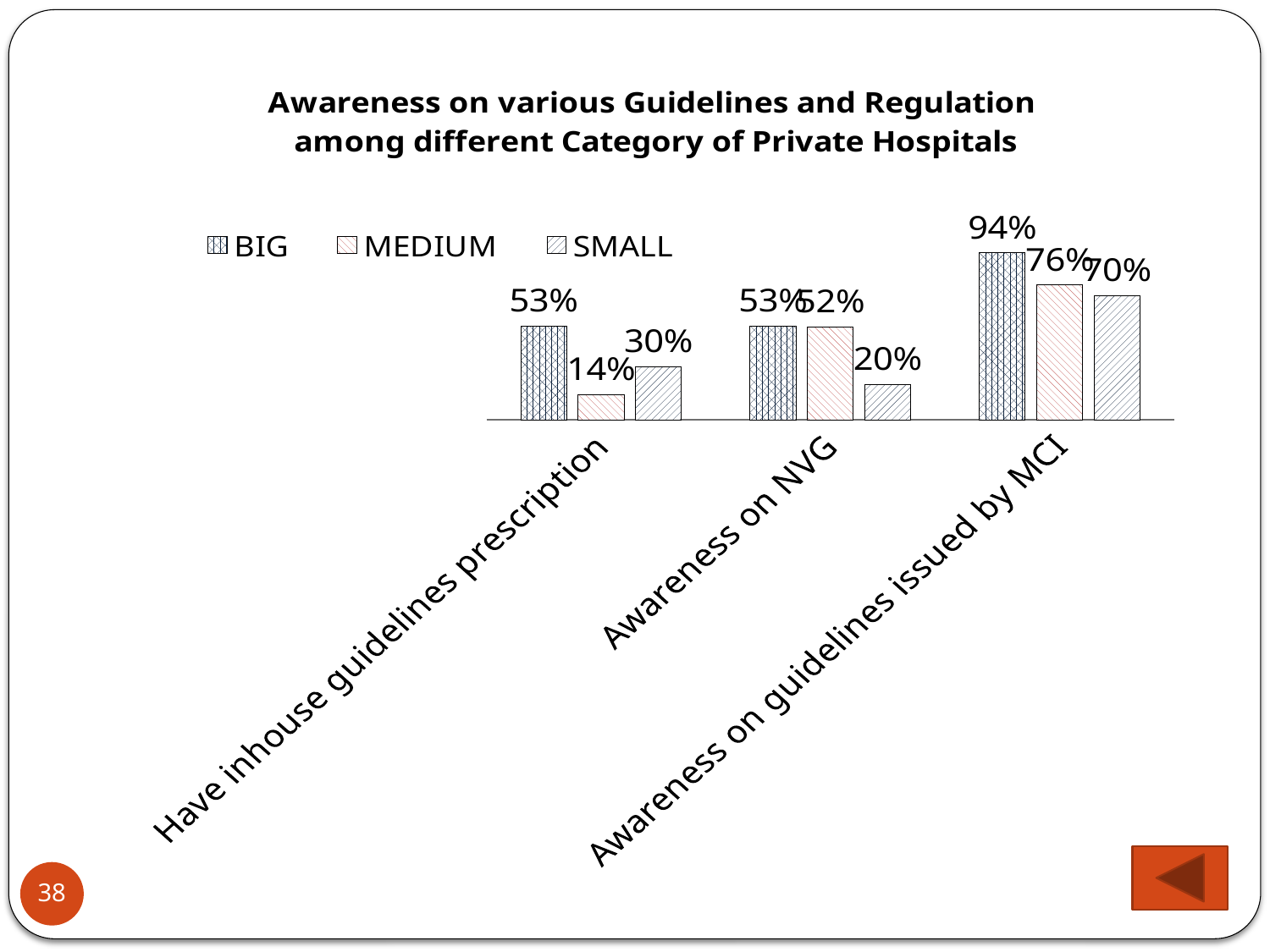
What is the difference between the SMALL and MEDIUM values in the 'Have inhouse guidelines prescription' category? 16% In the 'Have inhouse guidelines prescription' category, which is larger: the BIG value or the SMALL value? BIG How many categories are shown on the x axis? 3 What is the value for SMALL in the 'Awareness on NVG' category? 20% What is the difference between the BIG and MEDIUM values in the 'Awareness on guidelines issued by MCI' category? 18% What is the value for BIG in the 'Awareness on guidelines issued by MCI' category? 94% What is the value for MEDIUM in the 'Have inhouse guidelines prescription' category? 14% How many series does the legend list? 3 Which category has the highest value for the BIG series? Awareness on guidelines issued by MCI What kind of chart is shown on the slide? Bar chart What is the value for SMALL in the 'Awareness on guidelines issued by MCI' category? 70% Which category has the lowest value for the MEDIUM series? Have inhouse guidelines prescription